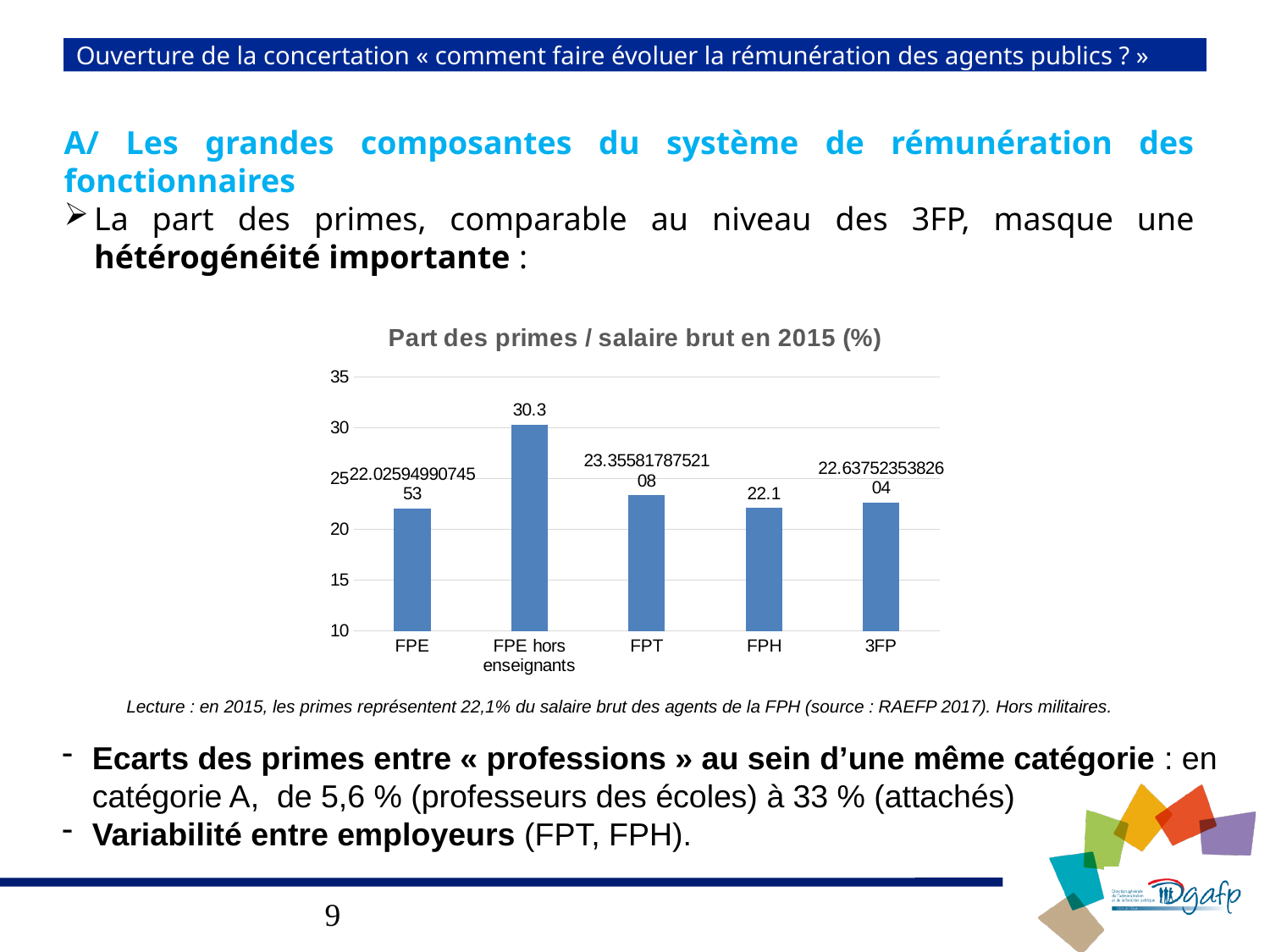
Is the value for FPE greater or less than 25? less What is the difference between the values for FPE hors enseignants and FPH? 8.2 How many categories are shown on the x axis of the chart? 5 Is the value for 3FP greater or less than 20? greater What is the value for FPH? 22.1 Which is larger, the value for FPT or the value for FPH? FPT Is the value for FPT greater or less than 25? less What type of chart is shown on the slide? bar chart Which category has the highest value? FPE hors enseignants What is the value for FPE hors enseignants? 30.3 What is the title of the chart? Part des primes / salaire brut en 2015 (%) Which is larger, the value for FPE hors enseignants or the value for 3FP? FPE hors enseignants